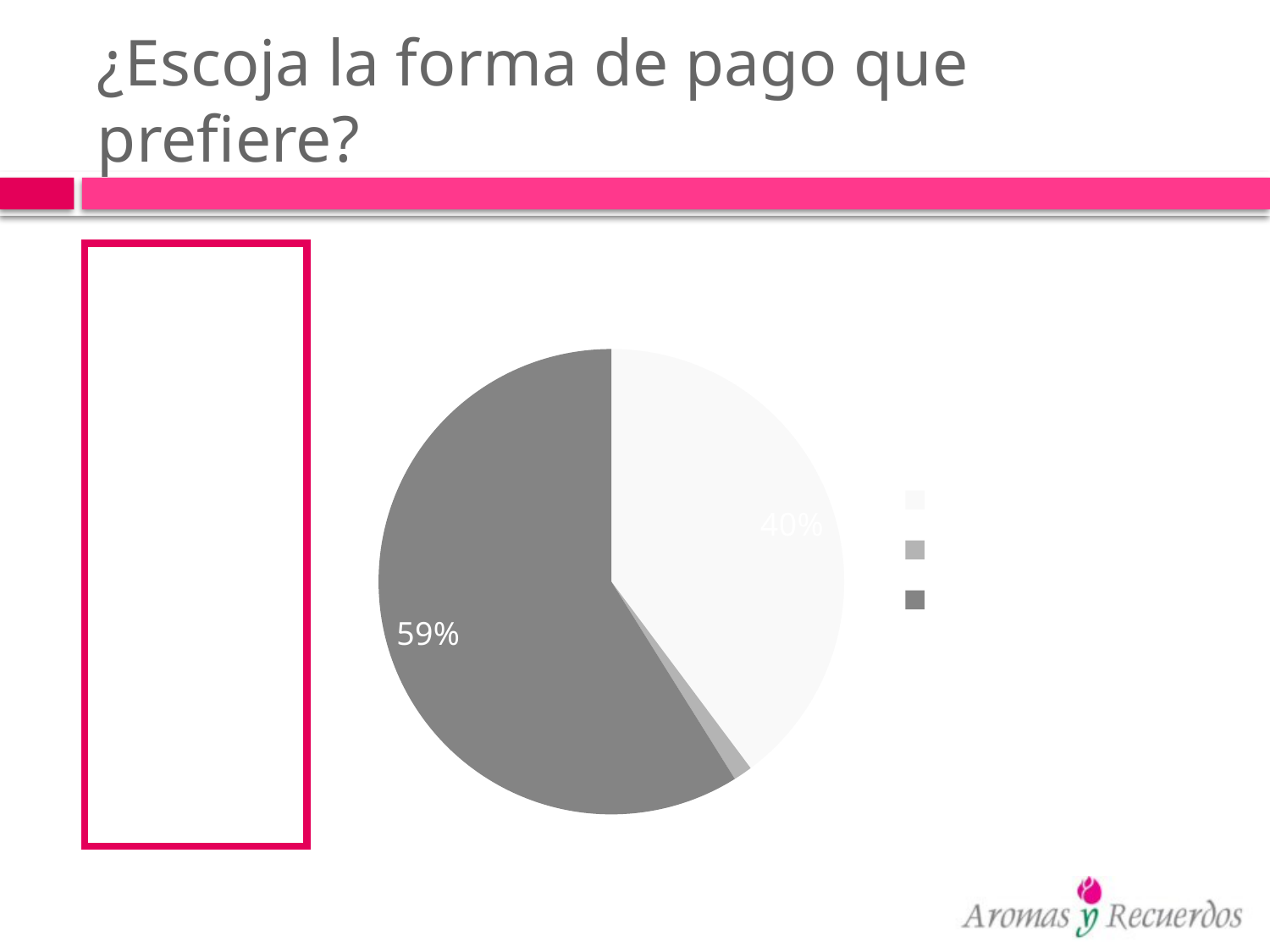
What percentage is shown on the light-coloured slice of the pie chart? 40% Which is larger, the dark gray slice or the light-coloured slice? the dark gray slice How many slices does the pie chart have? 3 What is the difference in percentage points between the 59% slice and the 40% slice? 19 percentage points Which slice of the pie chart is the largest? the dark gray slice (59%) Does the pie chart have a legend? yes What is the title of the slide containing the pie chart? ¿Escoja la forma de pago que prefiere? Is the dark gray slice greater or less than half of the pie? greater Which slice of the pie chart is the smallest? the small unlabeled medium-gray slice What kind of chart is shown on the slide? pie chart What percentage is shown on the dark gray slice of the pie chart? 59% How many entries does the legend of the pie chart list? 3